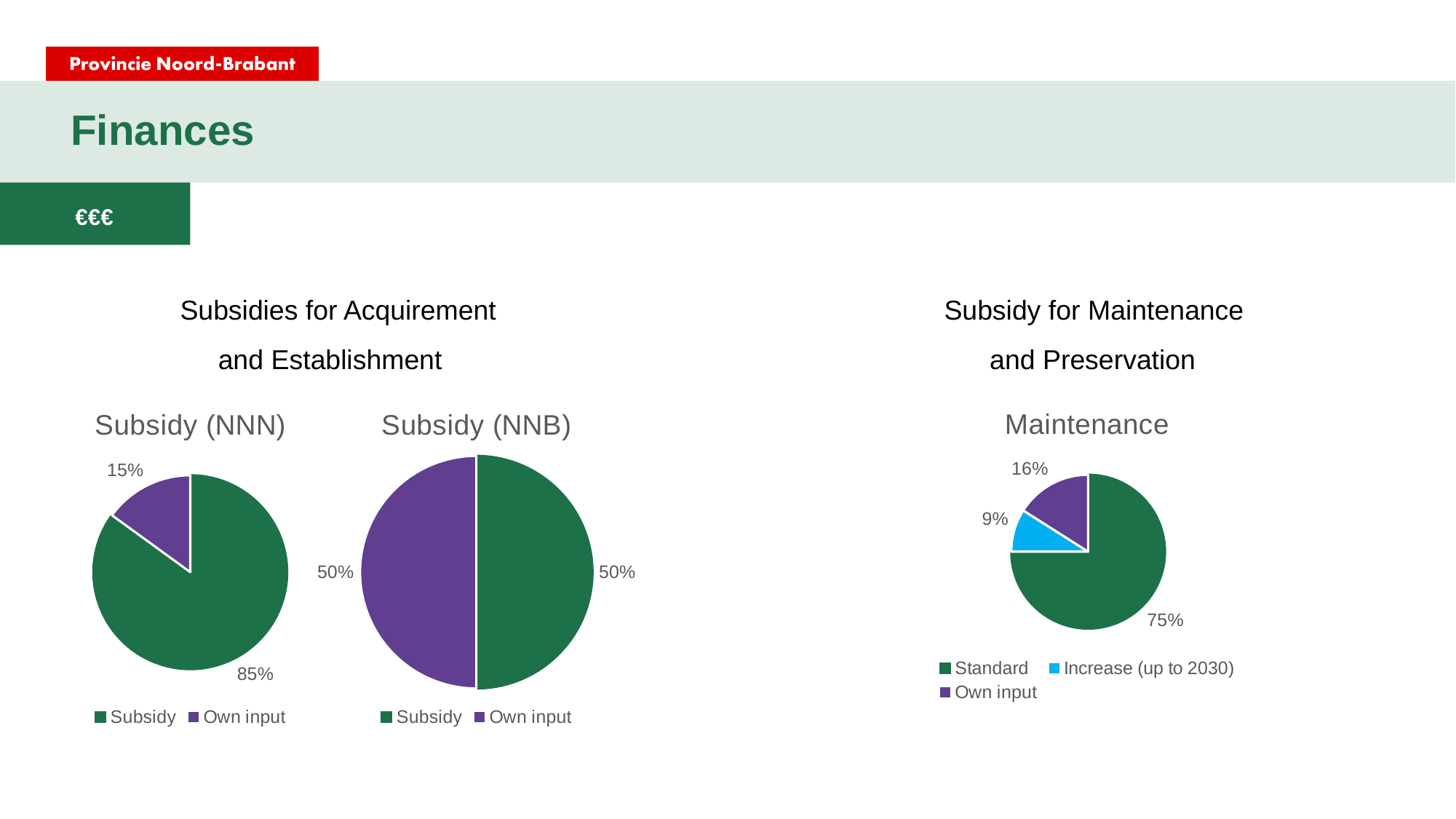
In the Subsidy (NNB) chart, what share does Own input have? 50% In the Maintenance chart, what share does Increase (up to 2030) have? 9% In the Subsidy (NNN) chart, what is the difference between the Subsidy and Own input shares? 70% What kind of chart is the Subsidy (NNB) chart? Pie chart In the Subsidy (NNN) chart, what share does Subsidy have? 85% In the Maintenance chart, which category has the smallest share? Increase (up to 2030) In the Subsidy (NNN) chart, what share does Own input have? 15% In the Maintenance chart, what colour is the Increase (up to 2030) slice? Blue In the Maintenance chart, what share does Own input have? 16% In the Subsidy (NNN) chart, which category has the largest share? Subsidy In the Maintenance chart, how many categories does the legend list? 3 In the Maintenance chart, what share does Standard have? 75%